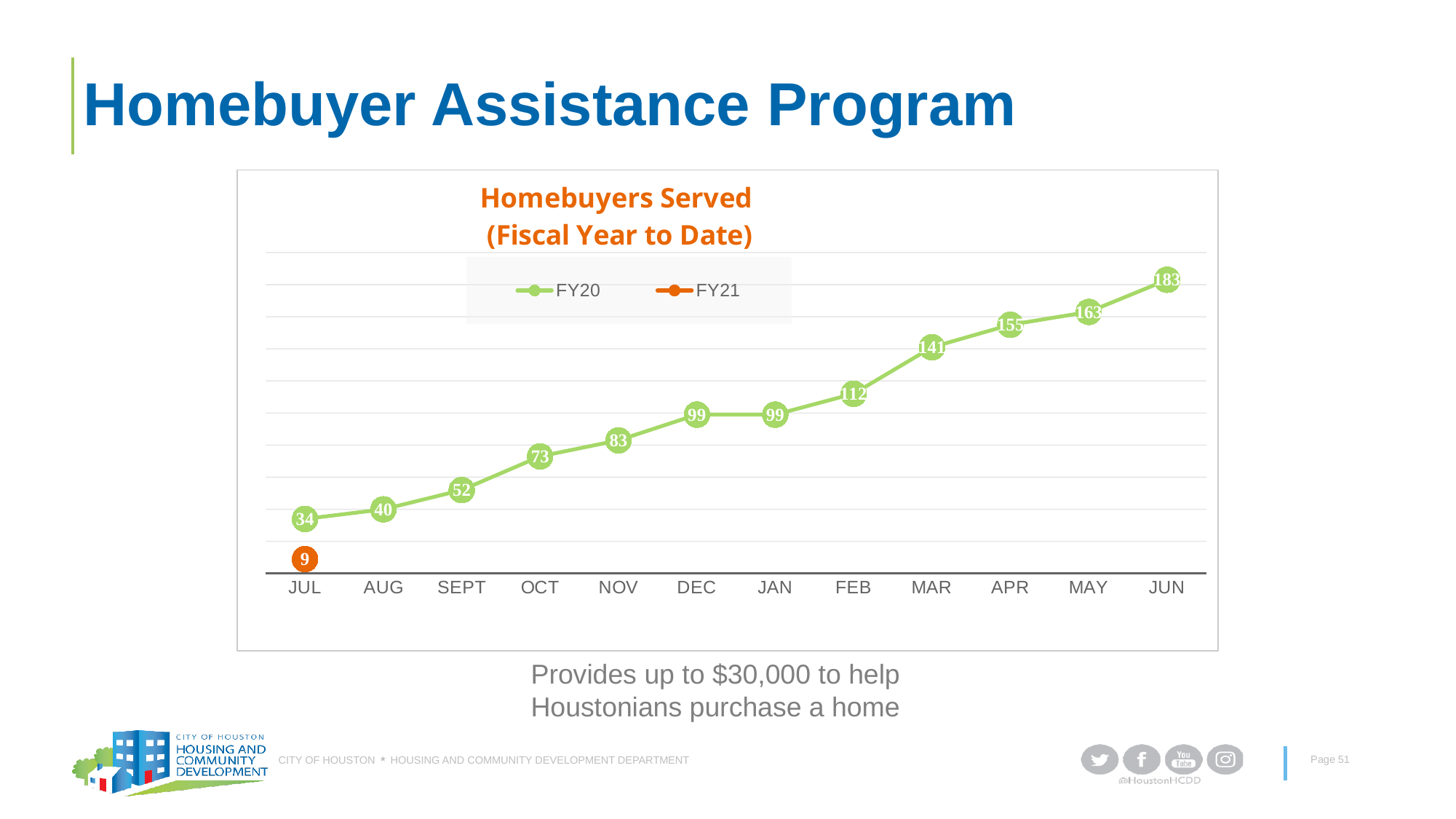
Do the FY20 values rise or fall from JUL to JUN? rise How many months are shown on the x axis? 12 What is the FY20 value for JUN? 183 What is the difference between the FY20 values for JUN and JUL? 149 What kind of chart is this? line chart What is the FY21 value for JUL? 9 Which month has the lowest FY20 value? JUL How many series does the legend list? 2 Which month has the highest FY20 value? JUN What is the FY20 value for NOV? 83 What is the difference between the FY20 and FY21 values for JUL? 25 Which is larger, the FY20 value for FEB or the FY20 value for MAR? MAR